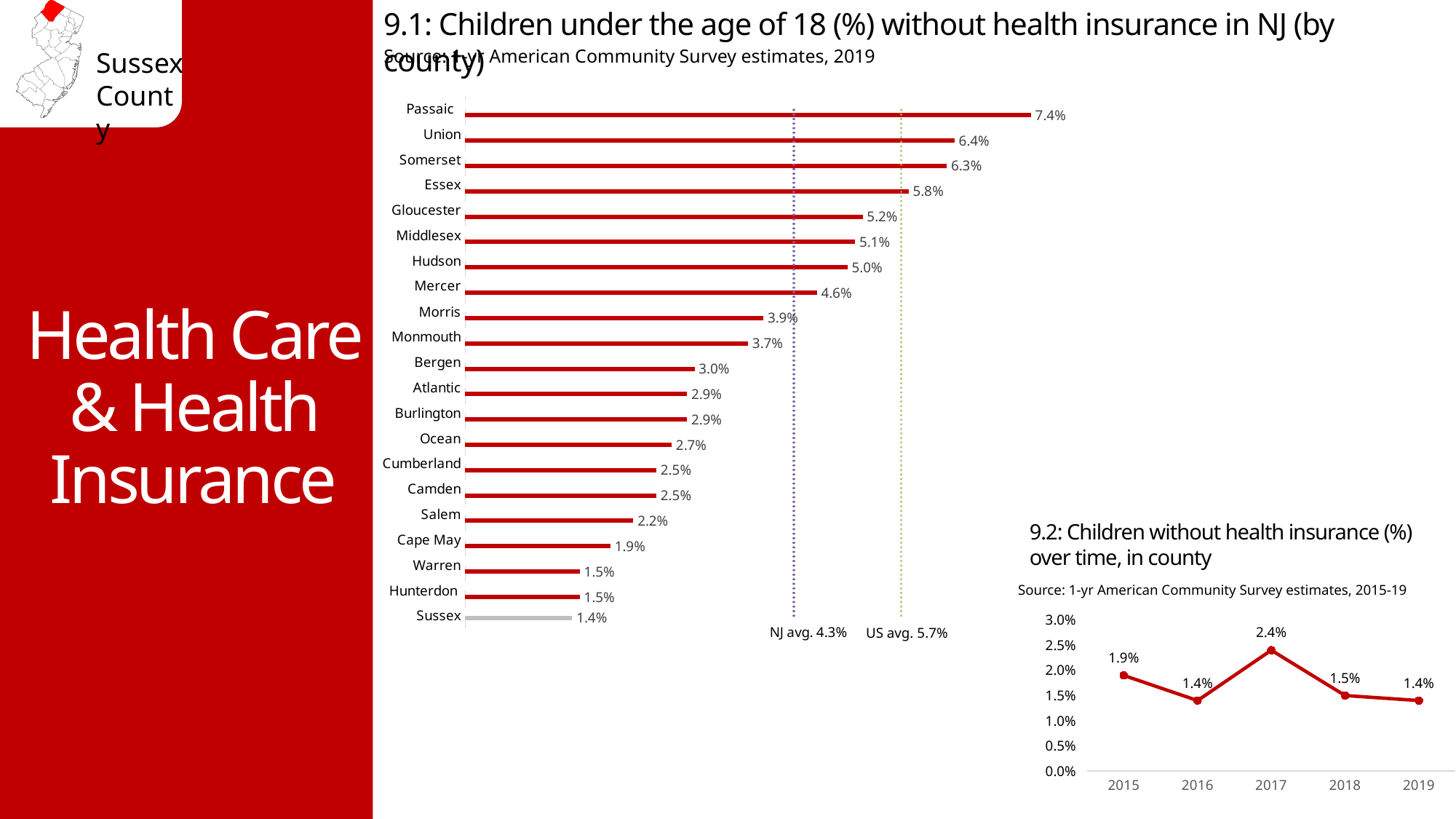
In chart 9.1 (children under 18 without health insurance by county), which county has the highest value? Passaic In chart 9.1 (children under 18 without health insurance by county), what is the value for Passaic? 7.4% In chart 9.1 (children under 18 without health insurance by county), which is larger, Bergen or Ocean? Bergen In chart 9.2 (children without health insurance over time), which year has the highest value? 2017 In chart 9.1 (children under 18 without health insurance by county), what is the NJ average shown by the dotted line? 4.3% In chart 9.1 (children under 18 without health insurance by county), what is the value for Sussex? 1.4% In chart 9.2 (children without health insurance over time), what is the difference between 2015 and 2019? 0.5% In chart 9.1 (children under 18 without health insurance by county), what is the difference between Union and Mercer? 1.8% What kind of chart is 9.2 (children without health insurance over time)? Line chart In chart 9.2 (children without health insurance over time), what is the value for 2017? 2.4% In chart 9.1 (children under 18 without health insurance by county), how many counties are plotted? 21 In chart 9.1 (children under 18 without health insurance by county), which county has the lowest value? Sussex